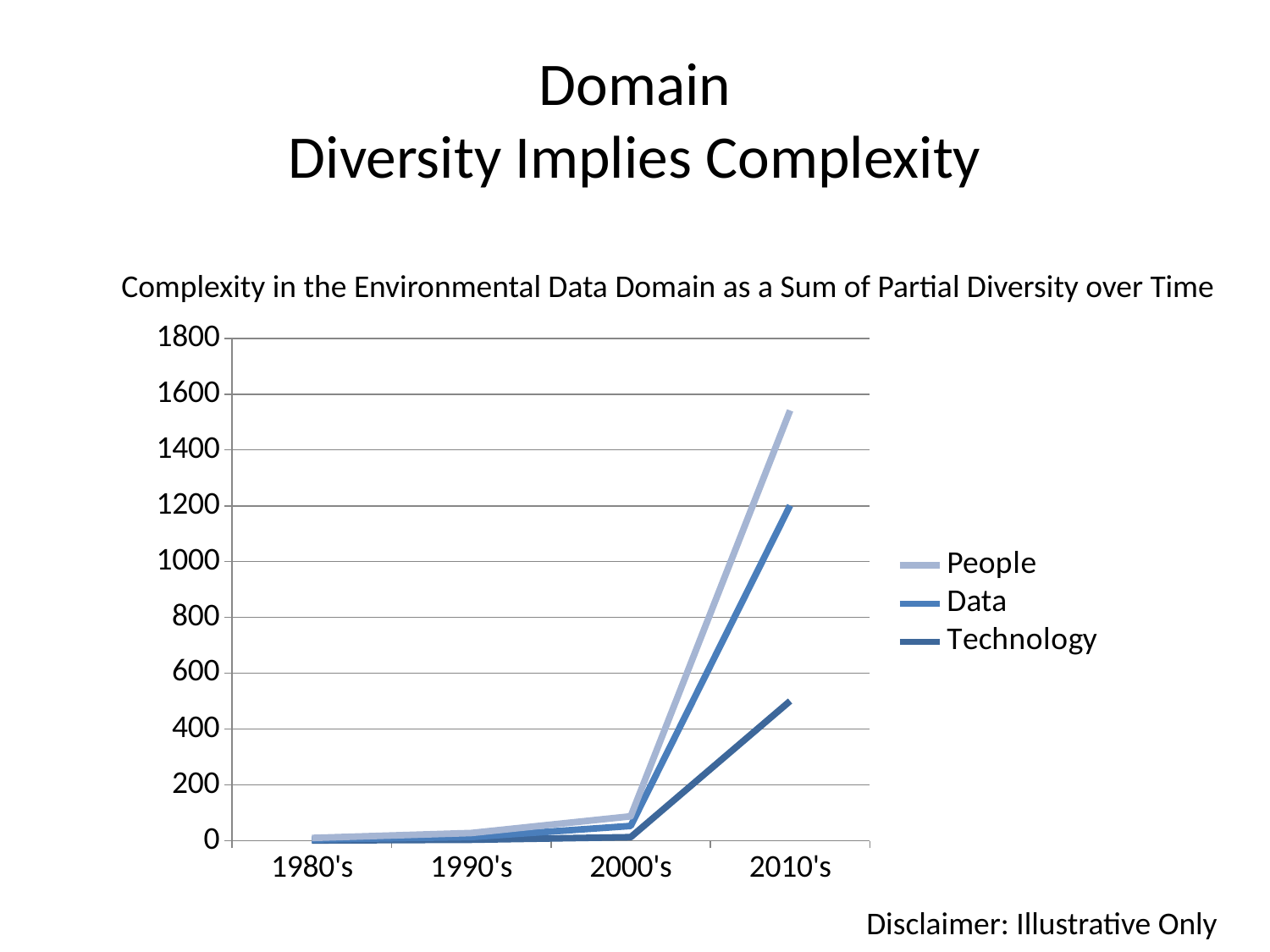
Is the value for People in the 2000's greater or less than 200? less How many series does the legend list? 3 How many decades are shown along the x axis? 4 What is the title of the chart? Complexity in the Environmental Data Domain as a Sum of Partial Diversity over Time Is the value for Technology in the 2010's greater or less than 600? less Do the values for People rise or fall from the 1980's to the 2010's? rise What kind of chart is shown on the slide? line chart